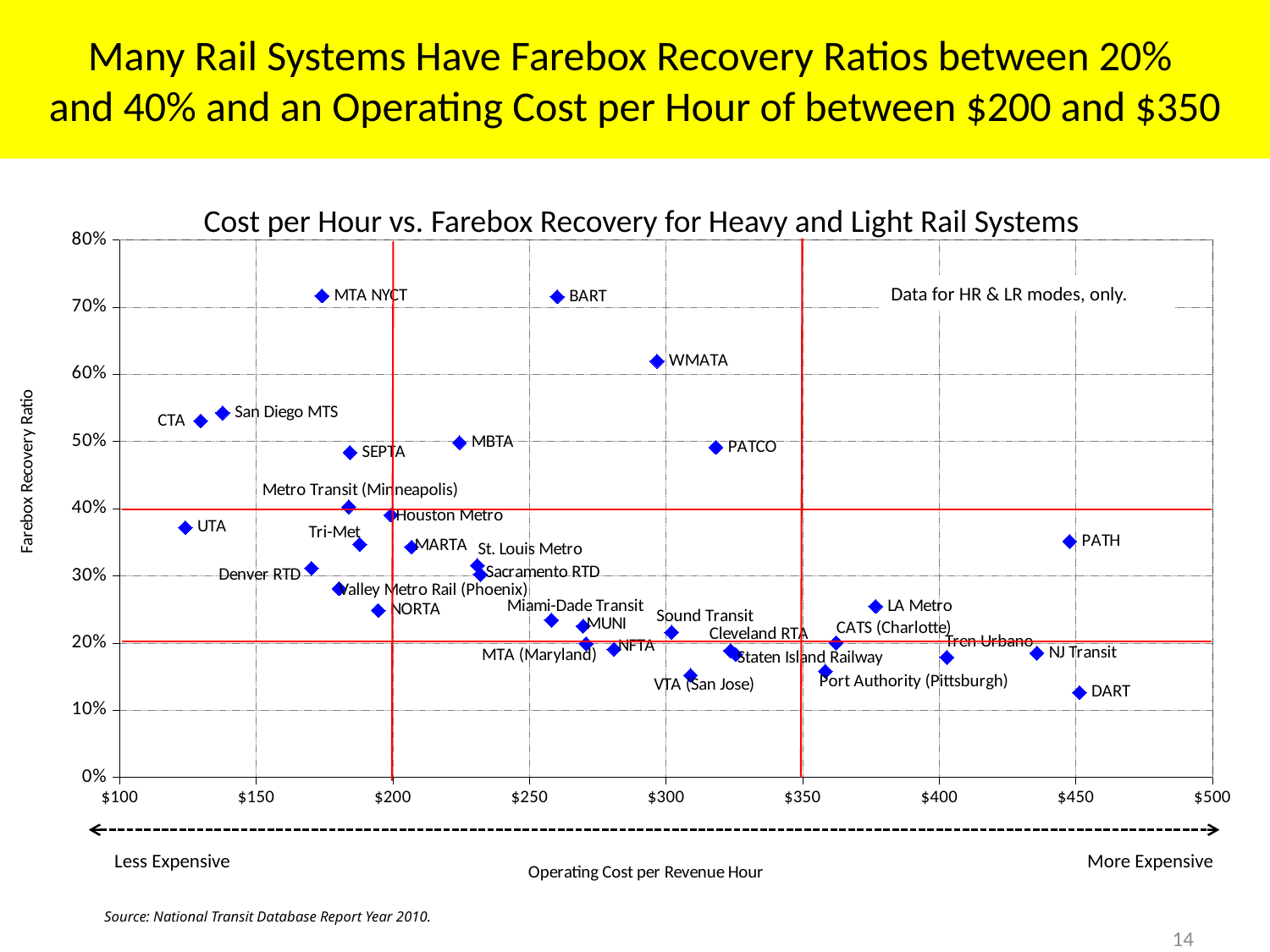
Which has the higher farebox recovery ratio, WMATA or PATCO? WMATA Is the farebox recovery ratio for MBTA greater or less than 40%? greater Which has the higher operating cost per revenue hour, PATH or UTA? PATH Is the farebox recovery ratio for WMATA greater or less than 50%? greater What kind of chart is shown on the slide? Scatter chart Which rail system has the lowest operating cost per revenue hour on the chart? UTA What is the title of the chart? Cost per Hour vs. Farebox Recovery for Heavy and Light Rail Systems Is the operating cost per revenue hour for UTA greater or less than $150? less What is the label of the vertical axis of the chart? Farebox Recovery Ratio